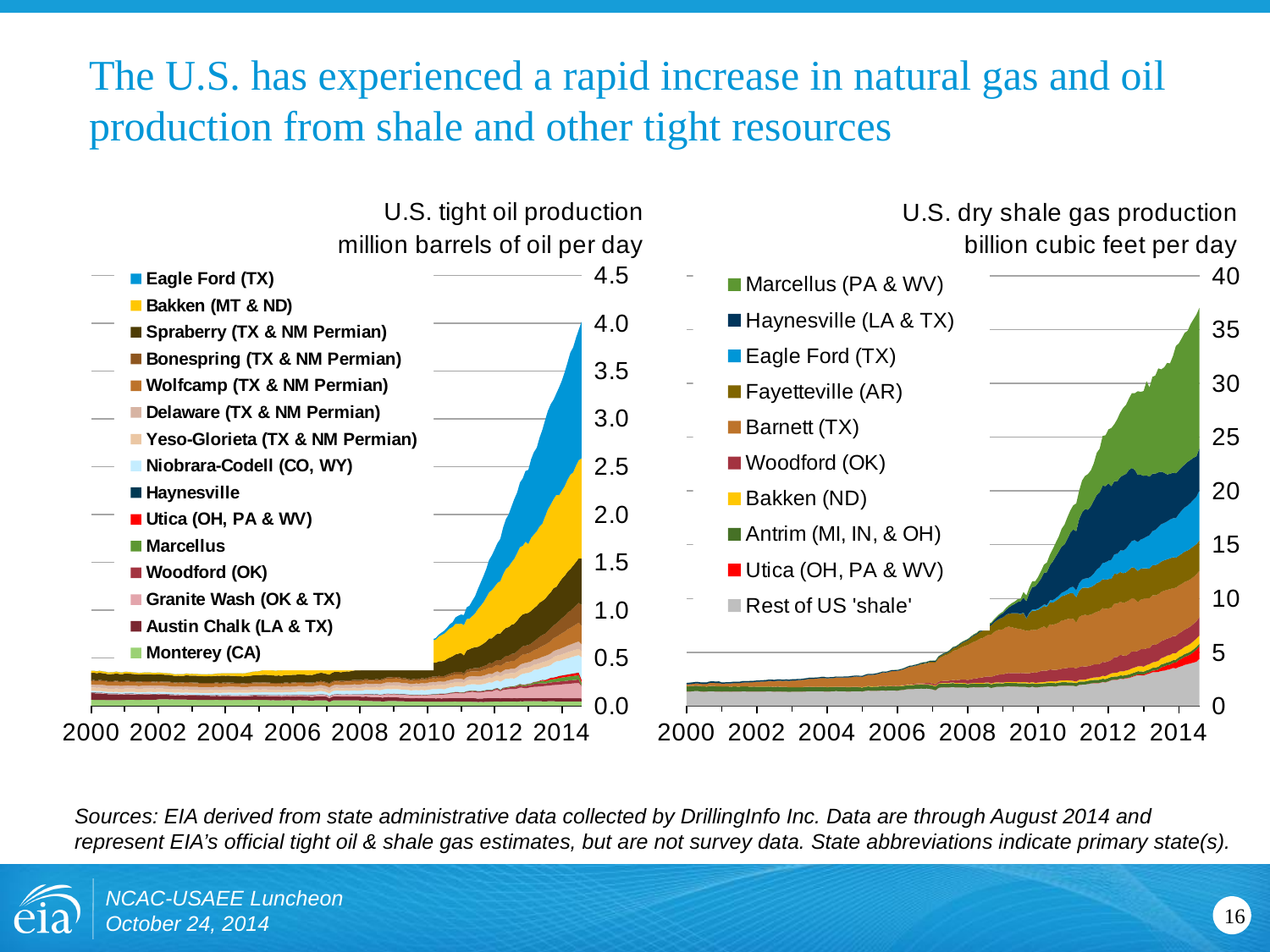
In the U.S. dry shale gas production chart, does total production rise or fall from 2000 to 2014? Rise How many series does the legend of the U.S. tight oil production chart list? 15 What unit is used on the y axis of the U.S. dry shale gas production chart? billion cubic feet per day What kind of chart is the U.S. tight oil production chart? Stacked area chart In the U.S. dry shale gas production chart, is total production in 2000 greater or less than 5 billion cubic feet per day? less In the U.S. dry shale gas production chart, is total production at the end of 2014 greater or less than 35 billion cubic feet per day? greater In the U.S. tight oil production chart, is total production in 2000 greater or less than 0.5 million barrels per day? less What kind of chart is the U.S. dry shale gas production chart? Stacked area chart In the U.S. tight oil production chart, does total production rise or fall from 2000 to 2014? Rise Which series is listed first in the legend of the U.S. tight oil production chart? Eagle Ford (TX) How many series does the legend of the U.S. dry shale gas production chart list? 10